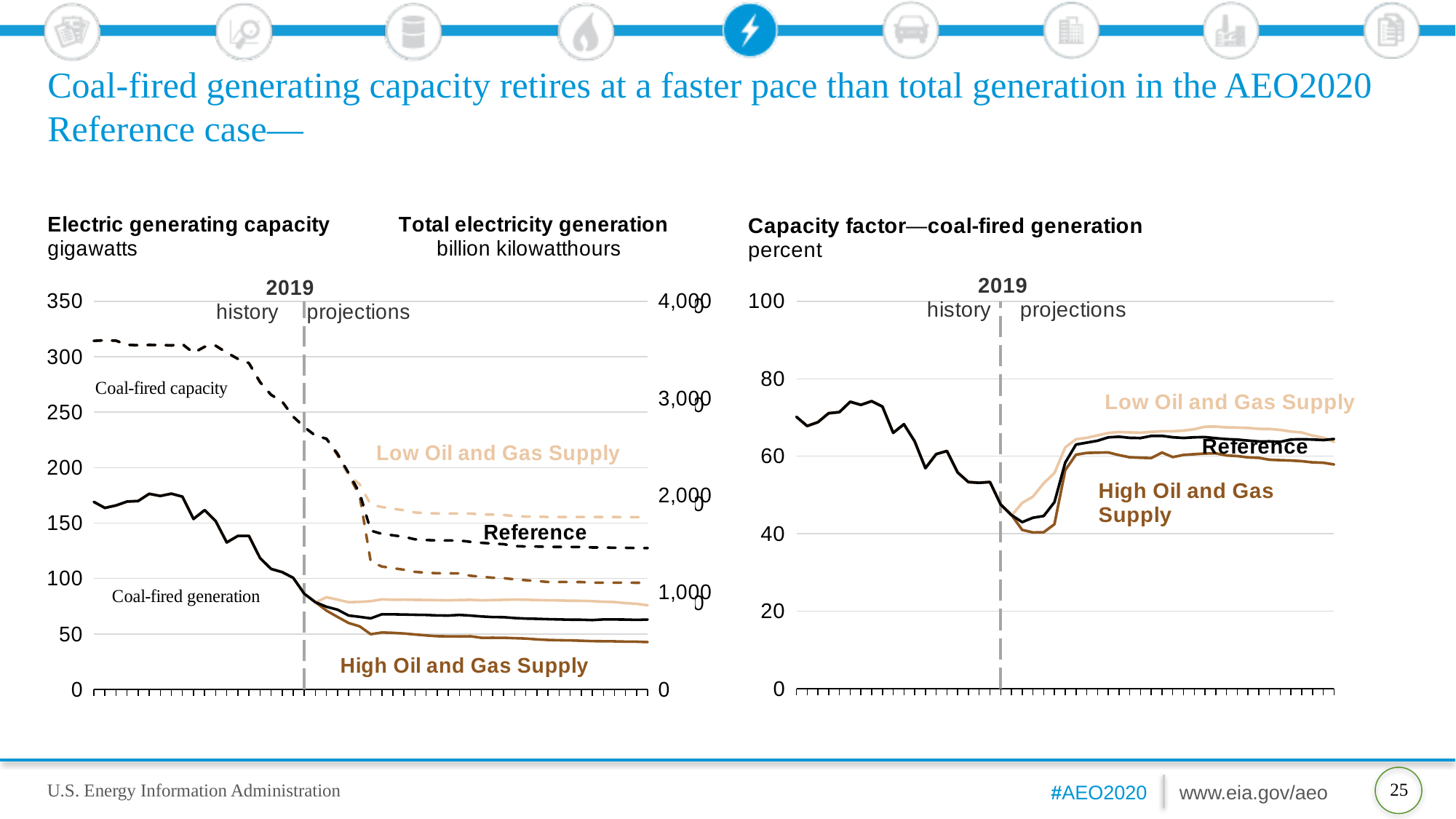
In the left chart, is the Reference case coal-fired generation at the end of the projection period greater or less than 1,000 billion kilowatthours? less What is the maximum value shown on the left-hand axis of the left chart, 'Electric generating capacity'? 350 In the left chart, does coal-fired capacity rise or fall over the history period? fall In the left chart, is the coal-fired capacity at the start of the history period greater or less than 300 gigawatts? greater What kind of chart is the left chart, 'Electric generating capacity / Total electricity generation'? line chart In the right chart, 'Capacity factor—coal-fired generation', does the capacity factor rise or fall over the history period? fall In the right chart, 'Capacity factor—coal-fired generation', is the Low Oil and Gas Supply value at the end of the projection period greater or less than 60 percent? greater How many named scenarios are labelled in the right chart, 'Capacity factor—coal-fired generation'? 3 In the right chart, 'Capacity factor—coal-fired generation', which scenario has the lowest capacity factor at the end of the projection period? High Oil and Gas Supply In the left chart, which scenario has the higher coal-fired capacity at the end of the projection period, Low Oil and Gas Supply or High Oil and Gas Supply? Low Oil and Gas Supply In the right chart, 'Capacity factor—coal-fired generation', what year separates history from projections? 2019